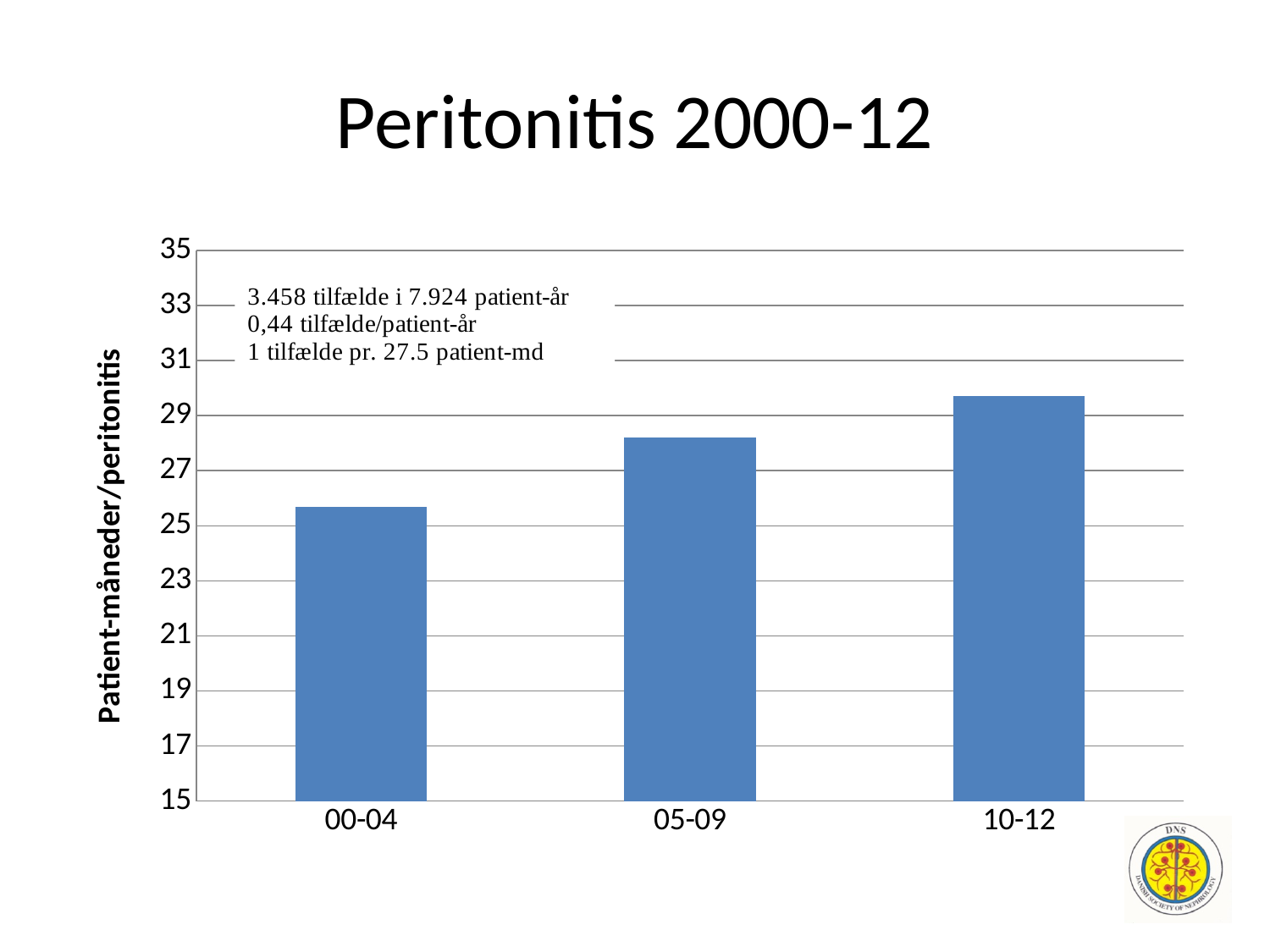
Which period has the highest value in the chart? 10-12 Is the value for 00-04 greater or less than 25? greater What is the label on the y axis of the chart? Patient-måneder/peritonitis Which period has the lowest value in the chart? 00-04 Is the value for 05-09 greater or less than 27? greater What kind of chart is shown on the slide? bar chart Is the value for 00-04 greater or less than 27? less What is the title of the slide containing the chart? Peritonitis 2000-12 Do the values rise or fall from 00-04 to 10-12? rise How many categories are shown on the x axis of the chart? 3 Which is larger, the value for 05-09 or the value for 00-04? 05-09